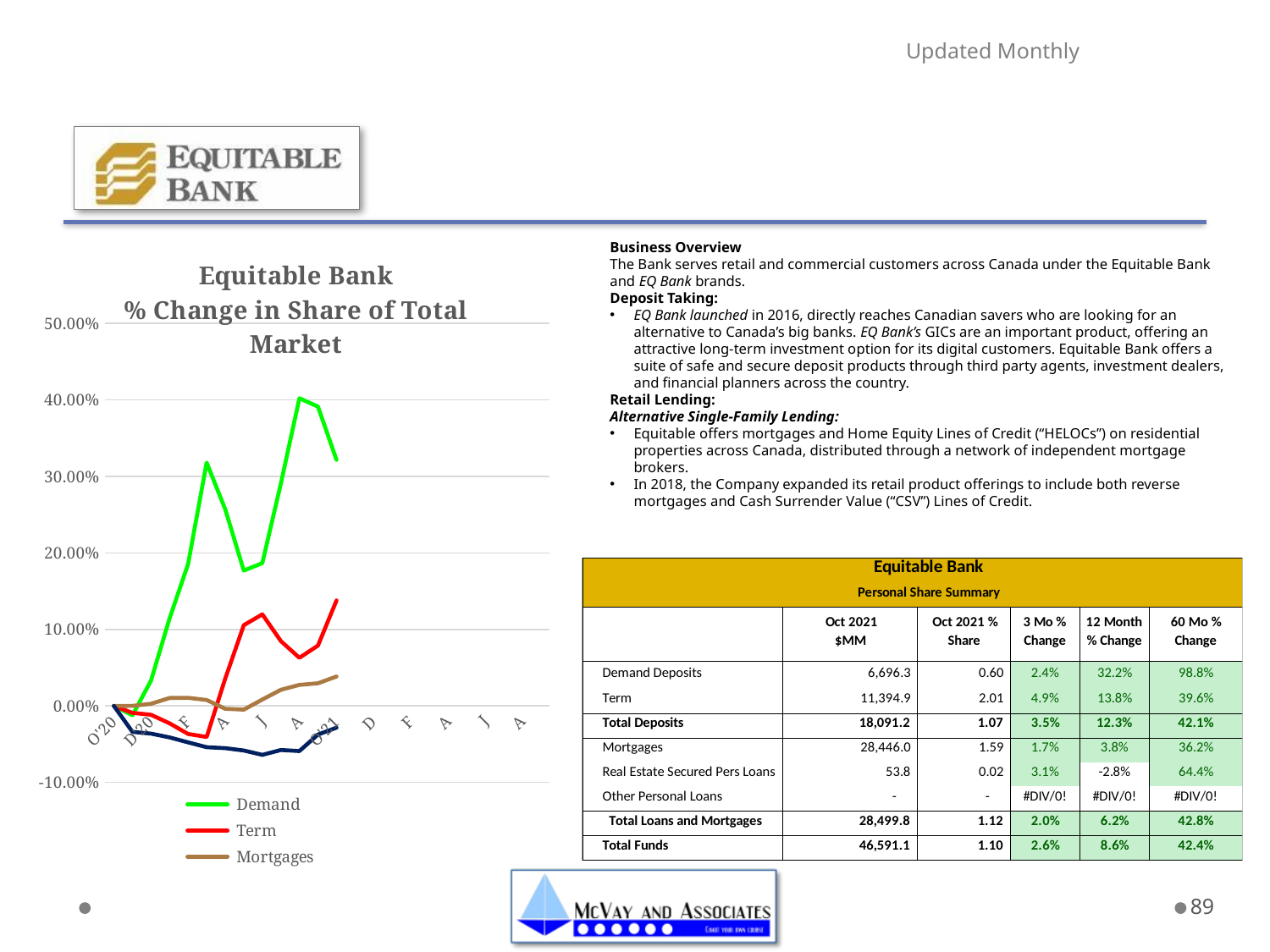
At O'21, which is larger, the Term value or the Mortgages value? Term How many series does the chart legend list? 3 What kind of chart is shown on the slide? line chart Does the Demand line overall rise or fall from O'20 to O'21? rise What is the title of the chart? Equitable Bank % Change in Share of Total Market Is the value of the Term line at O'21 greater or less than 10.00%? greater Is the lowest point of the Term line greater or less than 0.00%? less Is the value of the Mortgages line at O'21 greater or less than 10.00%? less Which colour is used for the Demand line in the chart? green Which of the legend series has the highest value at O'21? Demand